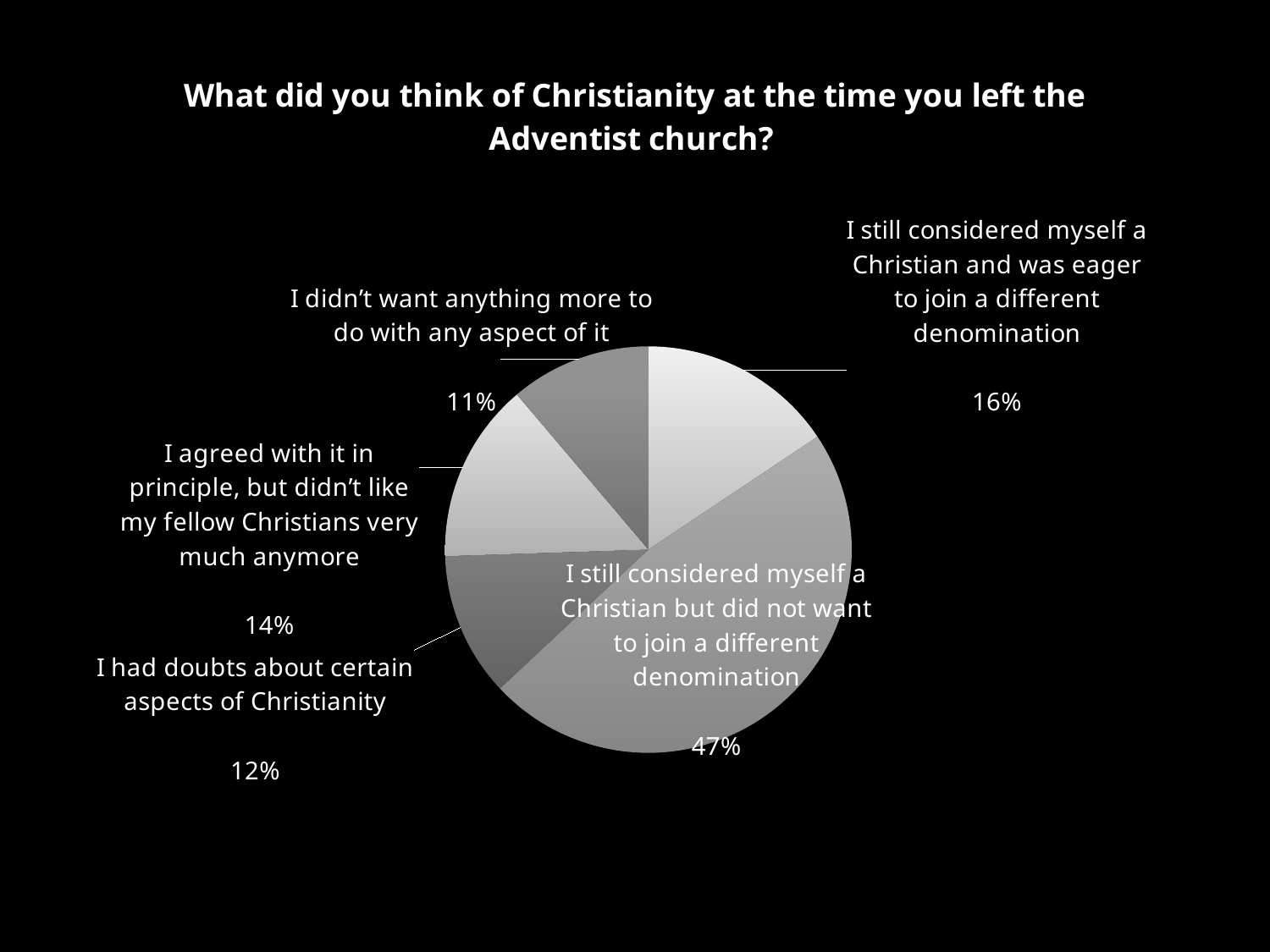
What share of respondents said "I didn't want anything more to do with any aspect of it"? 11% Which is larger: the share for "I agreed with it in principle, but didn't like my fellow Christians very much anymore" or the share for "I had doubts about certain aspects of Christianity"? I agreed with it in principle, but didn't like my fellow Christians very much anymore How many slices does the pie chart have? 5 Which response has the largest share of the pie? I still considered myself a Christian but did not want to join a different denomination What is the difference in percentage points between "I still considered myself a Christian but did not want to join a different denomination" and "I still considered myself a Christian and was eager to join a different denomination"? 31 percentage points What share of respondents said "I had doubts about certain aspects of Christianity"? 12% What share of respondents said "I still considered myself a Christian but did not want to join a different denomination"? 47% What is the title of the chart? What did you think of Christianity at the time you left the Adventist church? What type of chart is shown on the slide? Pie chart Which response has the smallest share of the pie? I didn't want anything more to do with any aspect of it What share of respondents said "I still considered myself a Christian and was eager to join a different denomination"? 16% What share of respondents said "I agreed with it in principle, but didn't like my fellow Christians very much anymore"? 14%